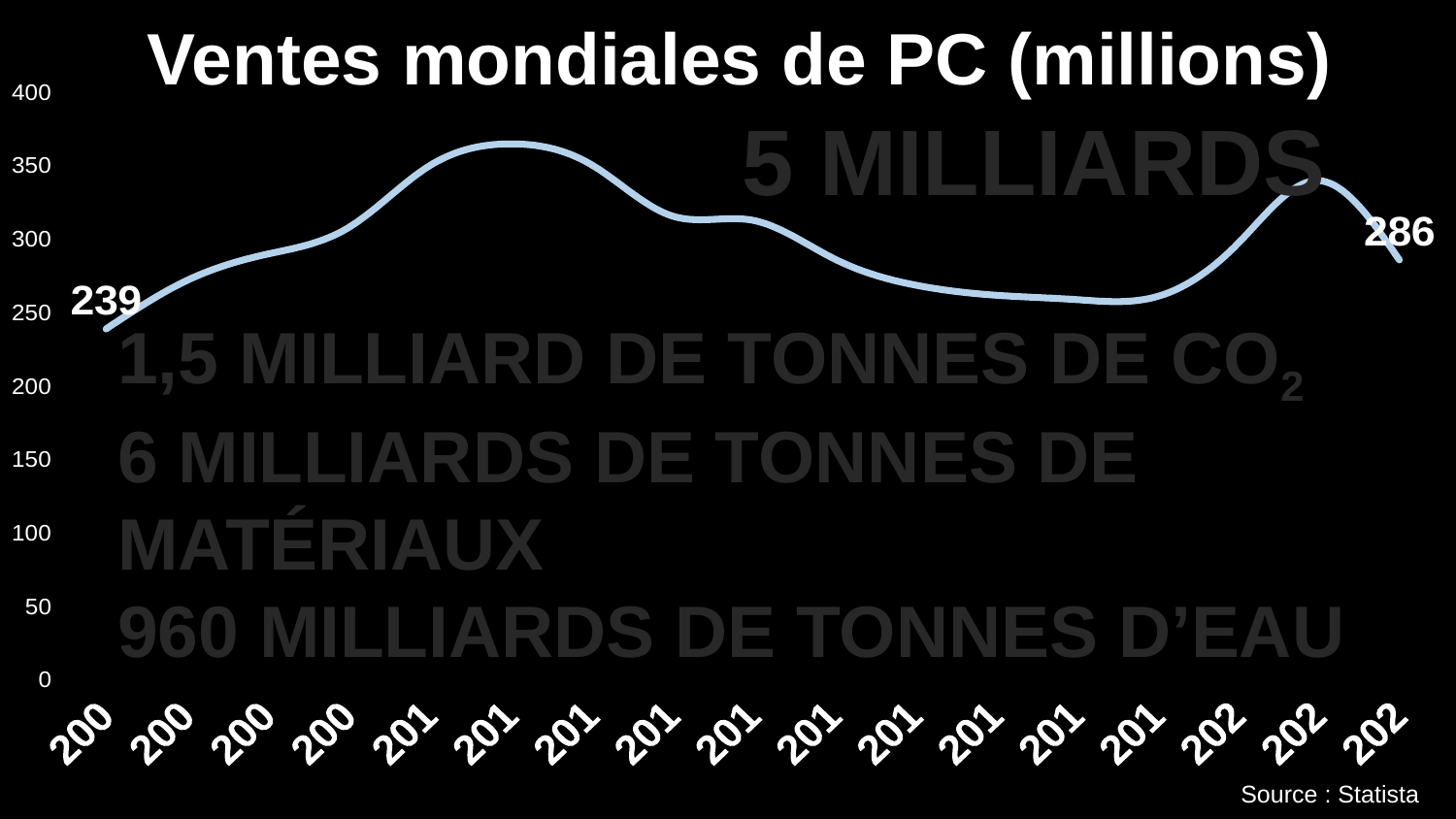
How many data points are plotted on the line? 17 Does the line end higher or lower than it starts? higher What is the maximum value shown on the vertical axis? 400 Is the lowest point of the line greater or less than 300? less What is the title of the chart? Ventes mondiales de PC (millions) What kind of chart is shown on the slide? line chart Which is larger, the first labelled value or the last labelled value on the line? the last (286) Is the first value of the line greater or less than 250? less What is the value shown at the first point of the line? 239 What is the value shown at the last point of the line? 286 What is the difference between the last labelled value (286) and the first labelled value (239)? 47 Is the highest point of the line greater or less than 350? greater